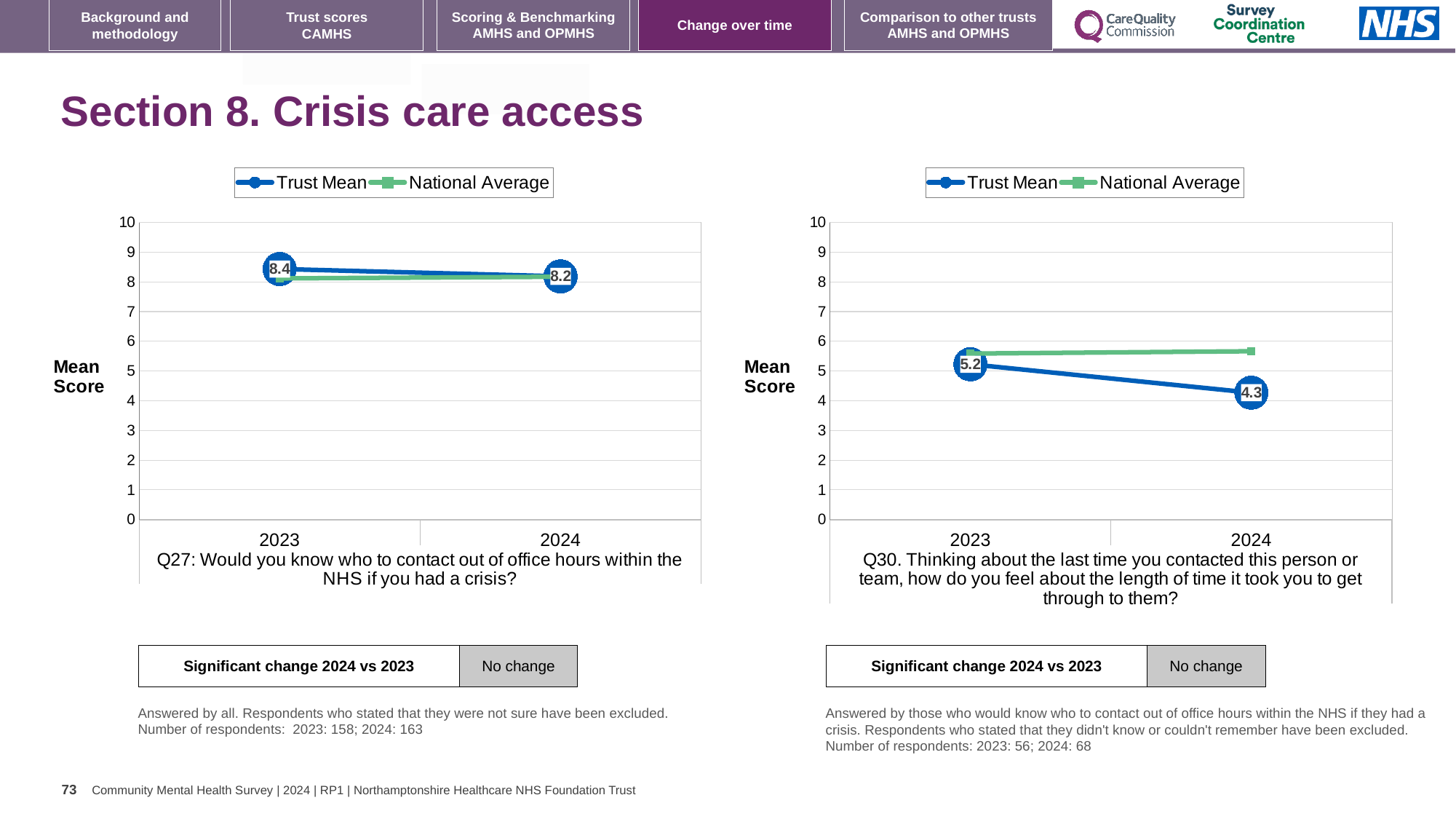
In the Q27 chart on the left, what is the Trust Mean score for 2024? 8.2 In the Q30 chart on the right, which is higher in 2024, the Trust Mean or the National Average? National Average In the Q30 chart on the right, what is the Trust Mean score for 2023? 5.2 In the Q30 chart on the right, by how much did the Trust Mean fall from 2023 to 2024? 0.9 In the Q30 chart on the right, is the National Average for 2024 greater or less than 5? greater In the Q30 chart on the right, does the Trust Mean rise or fall from 2023 to 2024? fall In the Q27 chart on the left, what is the difference between the Trust Mean in 2023 and 2024? 0.2 In the Q27 chart on the left, what is the Trust Mean score for 2023? 8.4 How many series does the legend of the Q27 chart on the left list? 2 In the Q30 chart on the right, what is the Trust Mean score for 2024? 4.3 What kind of chart is the Q27 chart on the left? line chart How many years are shown on the x axis of the Q30 chart on the right? 2